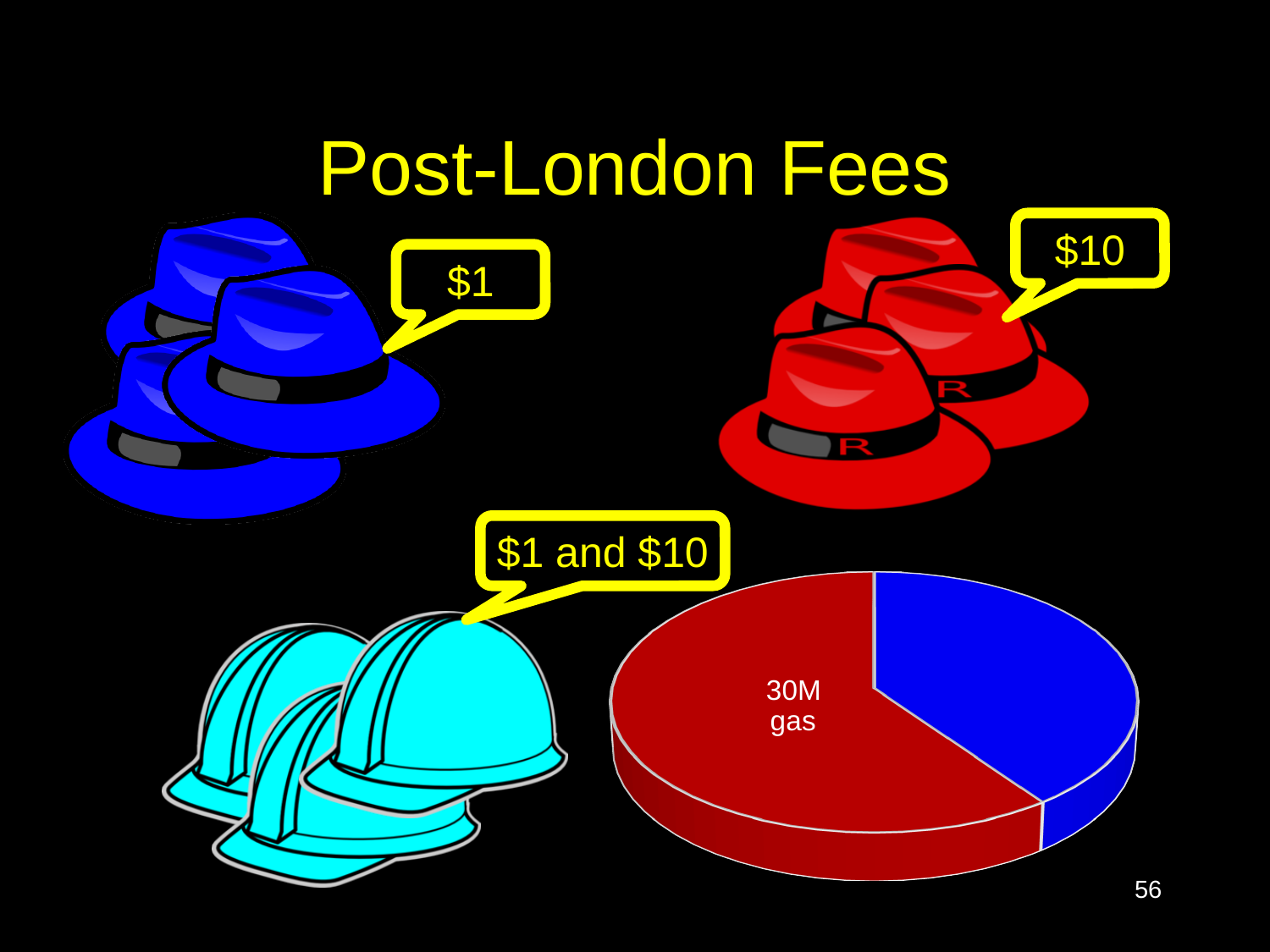
What is the title of the slide containing the pie chart? Post-London Fees What kind of chart is shown on the slide? pie chart Is the red slice of the pie chart more or less than half of the pie? more Which colour slice takes up the largest share of the pie chart? red What two colours are used for the slices of the pie chart? red and blue How many slices does the pie chart have? 2 What label is printed on the red slice of the pie chart? 30M gas Which colour slice takes up the smallest share of the pie chart? blue Which slice of the pie chart is larger, the red one or the blue one? red